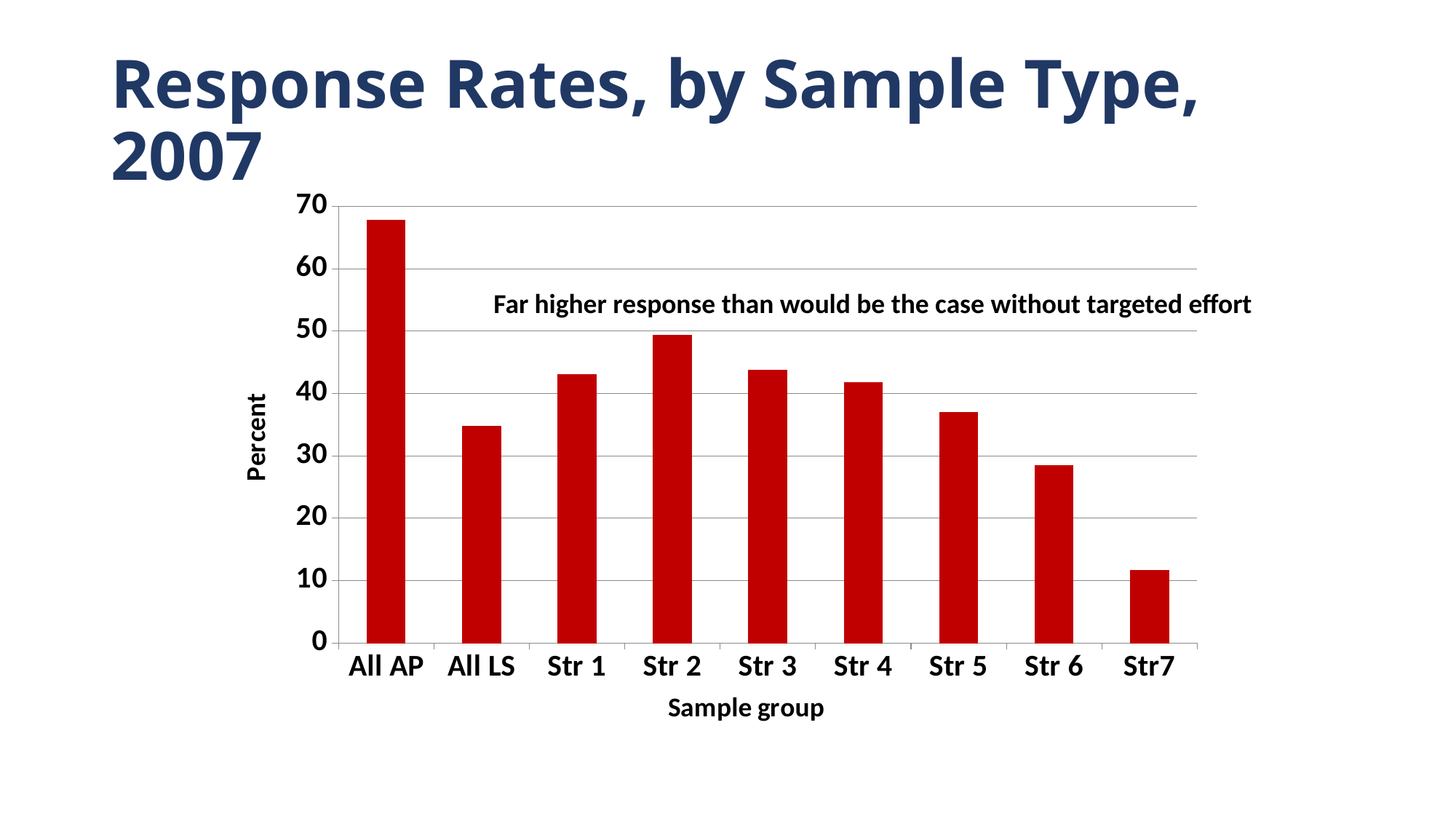
Which sample group has the lowest response rate? Str7 Is the value for Str 6 greater or less than 30? less Is the value for Str7 greater or less than 20? less Is the value for Str 2 greater or less than 40? greater Which sample group has the highest response rate? All AP Which has a higher response rate, Str 2 or Str 5? Str 2 What is the label of the x axis? Sample group How many sample groups are shown on the x axis? 9 What is the label of the y axis? Percent What kind of chart is shown on the slide? bar chart